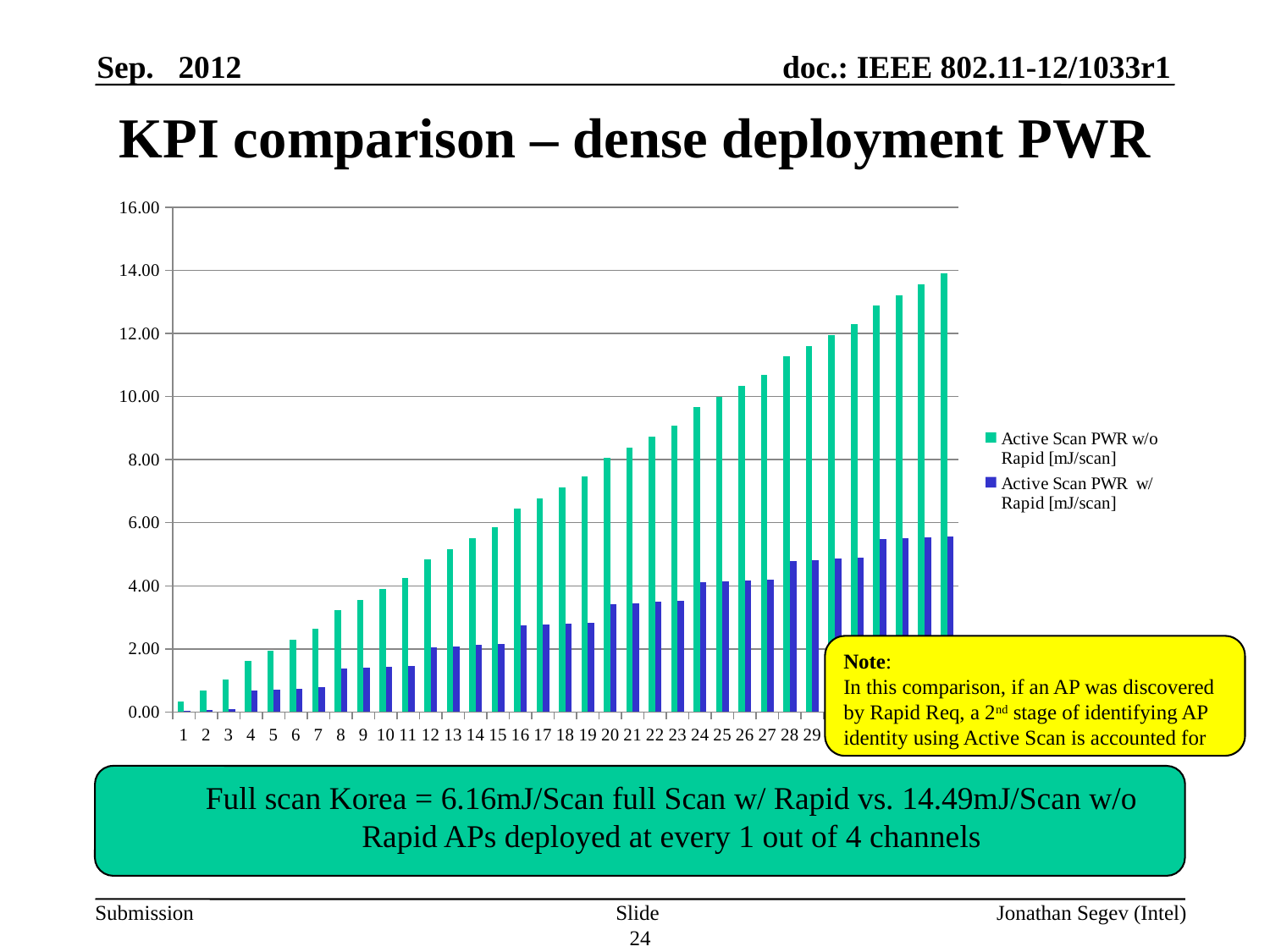
Is the value for Active Scan PWR w/o Rapid at category 1 greater or less than 2.00? less Is the value for Active Scan PWR w/ Rapid at category 8 greater or less than 2.00? less Do the values for Active Scan PWR w/ Rapid rise or fall as the category number increases along the x axis? rise At category 20, which series has the larger value: Active Scan PWR w/o Rapid or Active Scan PWR w/ Rapid? Active Scan PWR w/o Rapid Is the value for Active Scan PWR w/o Rapid at category 24 greater or less than 8.00? greater What is the highest value shown on the y axis of the chart? 16.00 Do the values for Active Scan PWR w/o Rapid rise or fall as the category number increases along the x axis? rise What kind of chart is shown on the slide? bar chart How many series does the legend list? 2 What are the two series named in the legend? Active Scan PWR w/o Rapid [mJ/scan] and Active Scan PWR w/ Rapid [mJ/scan]